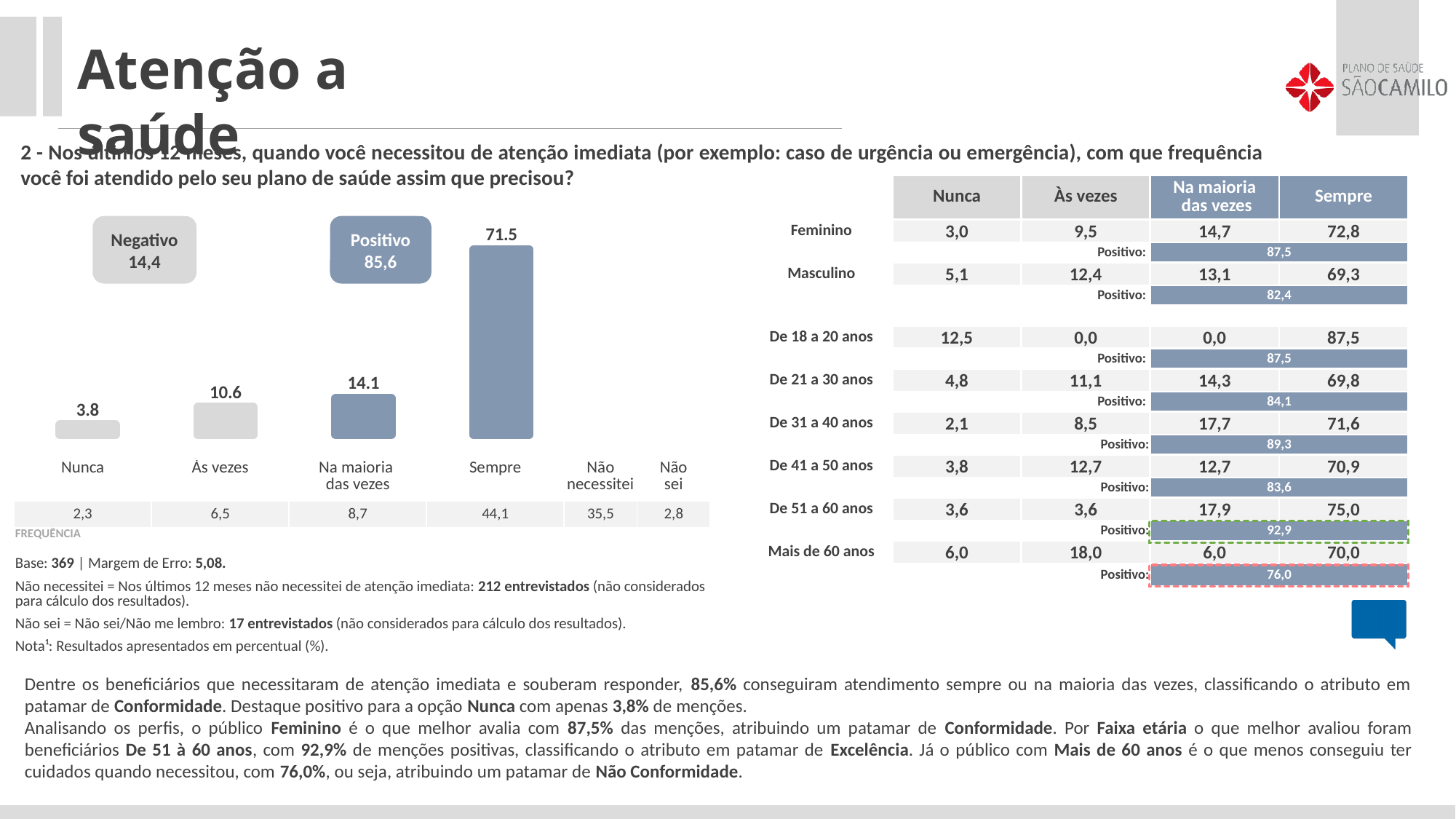
What is the value of the bar for 'Sempre' in the bar chart? 71.5 What type of chart is shown on the left of the slide? Bar chart Do the bar values rise or fall from 'Nunca' to 'Sempre' along the x axis of the bar chart? Rise What is the difference between the bars for 'Às vezes' and 'Nunca' in the bar chart? 6.8 Which category has the lowest bar in the bar chart? Nunca What is the value of the bar for 'Às vezes' in the bar chart? 10.6 In the bar chart, which is larger: the bar for 'Às vezes' or the bar for 'Na maioria das vezes'? Na maioria das vezes What is the value of the bar for 'Na maioria das vezes' in the bar chart? 14.1 What is the difference between the bars for 'Sempre' and 'Na maioria das vezes' in the bar chart? 57.4 Which category has the highest bar in the bar chart? Sempre What value is shown in the 'Positivo' box above the bar chart? 85,6 What is the value of the bar for 'Nunca' in the bar chart? 3.8